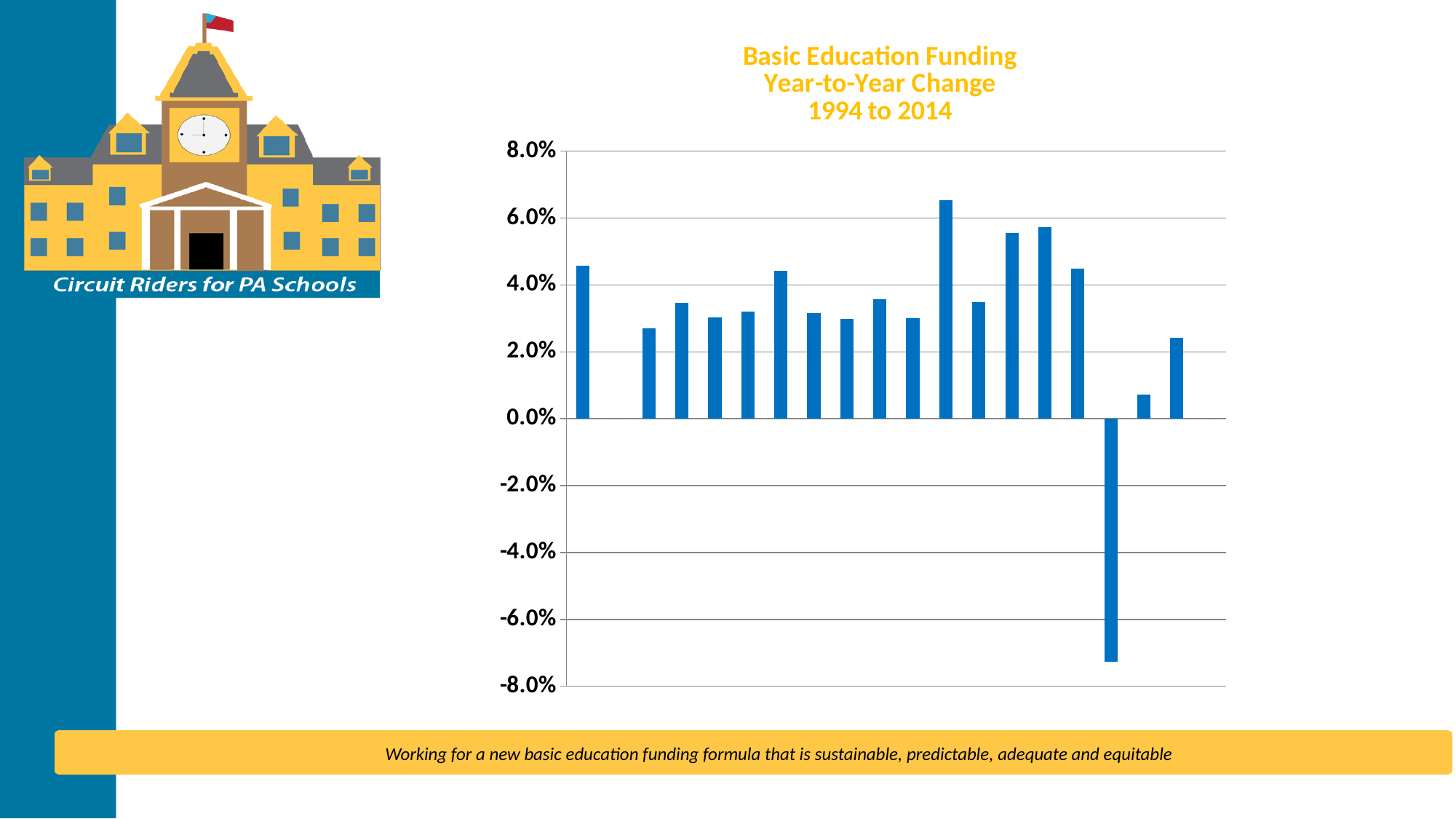
Is the value of the only negative bar greater or less than -6.0%? less What is the highest value shown on the vertical axis? 8.0% Is the value of the second-to-last bar greater or less than 2.0%? less What kind of chart is shown on the slide? bar chart Is the value of the second bar from the left greater or less than 4.0%? less What is the title of the chart? Basic Education Funding Year-to-Year Change 1994 to 2014 Which is larger: the tallest bar or the first (leftmost) bar? the tallest bar How many bars extend below 0.0% on the chart? 1